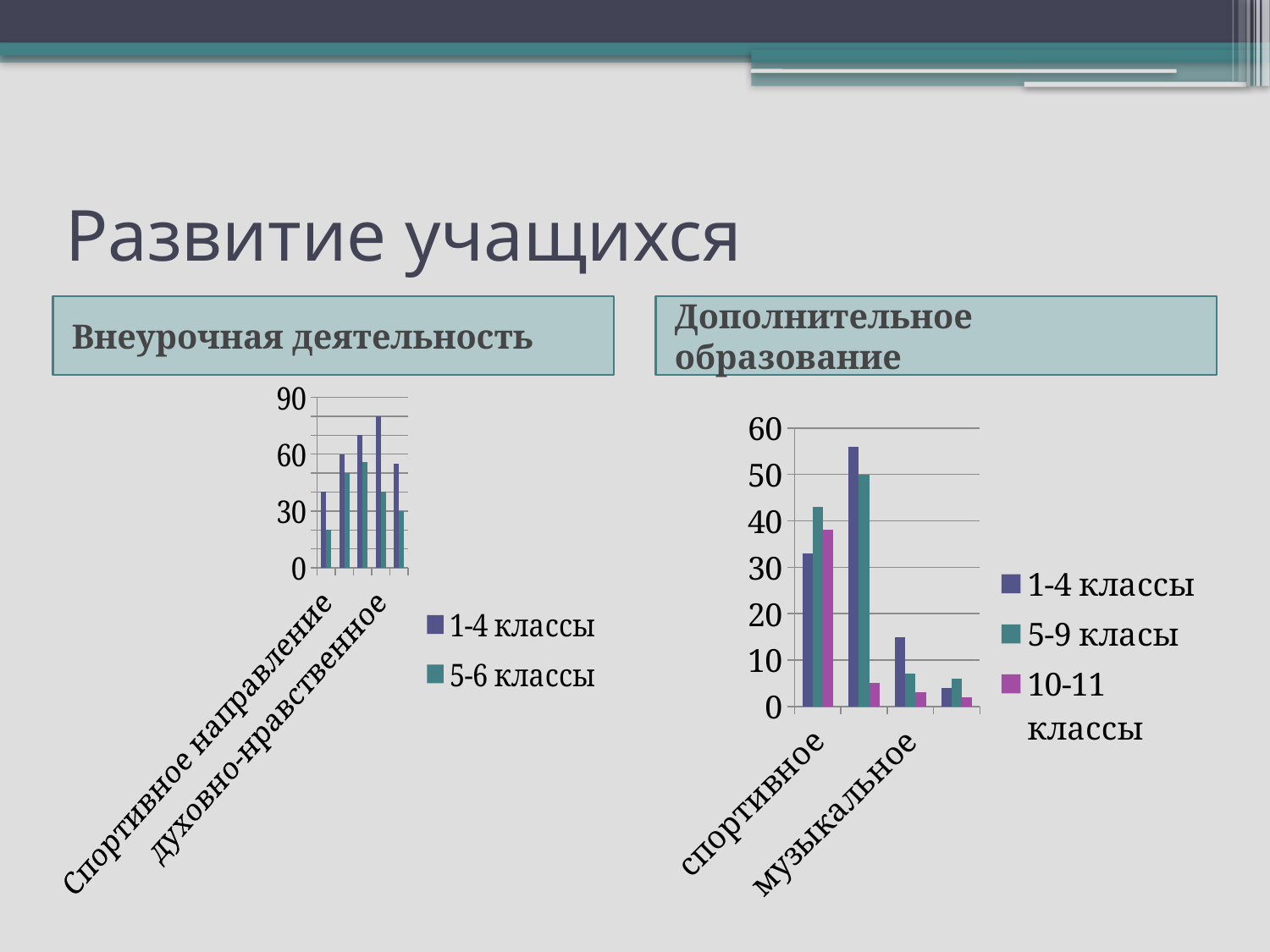
In the 'Дополнительное образование' chart, is the value for 5-9 класы in 'спортивное' greater or less than 40? greater What kind of chart is the 'Внеурочная деятельность' chart on the left? bar chart How many category groups of bars are plotted in the 'Внеурочная деятельность' chart? 5 In the 'Дополнительное образование' chart, which series contains the tallest bar overall? 1-4 классы How many category groups of bars are plotted in the 'Дополнительное образование' chart? 4 In the 'Внеурочная деятельность' chart, which series has the larger value for 'Спортивное направление', 1-4 классы or 5-6 классы? 1-4 классы In the 'Дополнительное образование' chart, is the value for 10-11 классы in 'музыкальное' greater or less than 10? less In the 'Дополнительное образование' chart, which series has the highest value for 'спортивное'? 5-9 класы In the 'Внеурочная деятельность' chart, is the value for 5-6 классы in 'Спортивное направление' greater or less than 30? less How many series does the legend of the 'Внеурочная деятельность' chart list? 2 How many series does the legend of the 'Дополнительное образование' chart list? 3